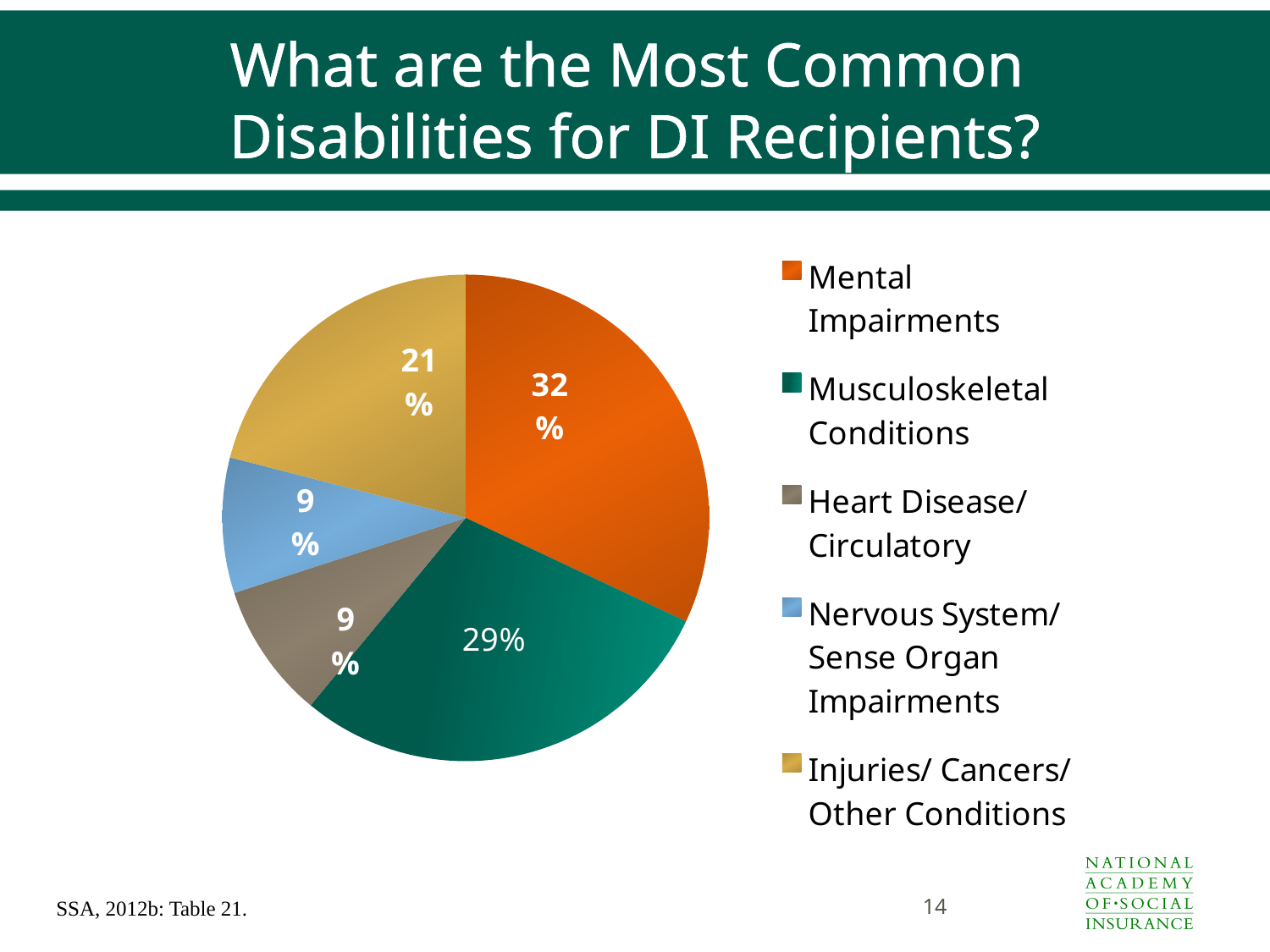
What type of chart is shown on the slide? Pie chart What share of DI recipients have Mental Impairments? 32% How many categories does the pie chart show? 5 Which disability category has the largest share of the pie? Mental Impairments What share of DI recipients have Musculoskeletal Conditions? 29% Which is larger: the share for Injuries/ Cancers/ Other Conditions or the share for Nervous System/ Sense Organ Impairments? Injuries/ Cancers/ Other Conditions What is the difference in percentage points between Mental Impairments and Musculoskeletal Conditions? 3 percentage points What share of DI recipients have Injuries/ Cancers/ Other Conditions? 21% What share of DI recipients have Nervous System/ Sense Organ Impairments? 9% What is the combined share of Mental Impairments and Musculoskeletal Conditions? 61% Which colour represents Musculoskeletal Conditions in the pie chart? Green (teal) What share of DI recipients have Heart Disease/ Circulatory conditions? 9%